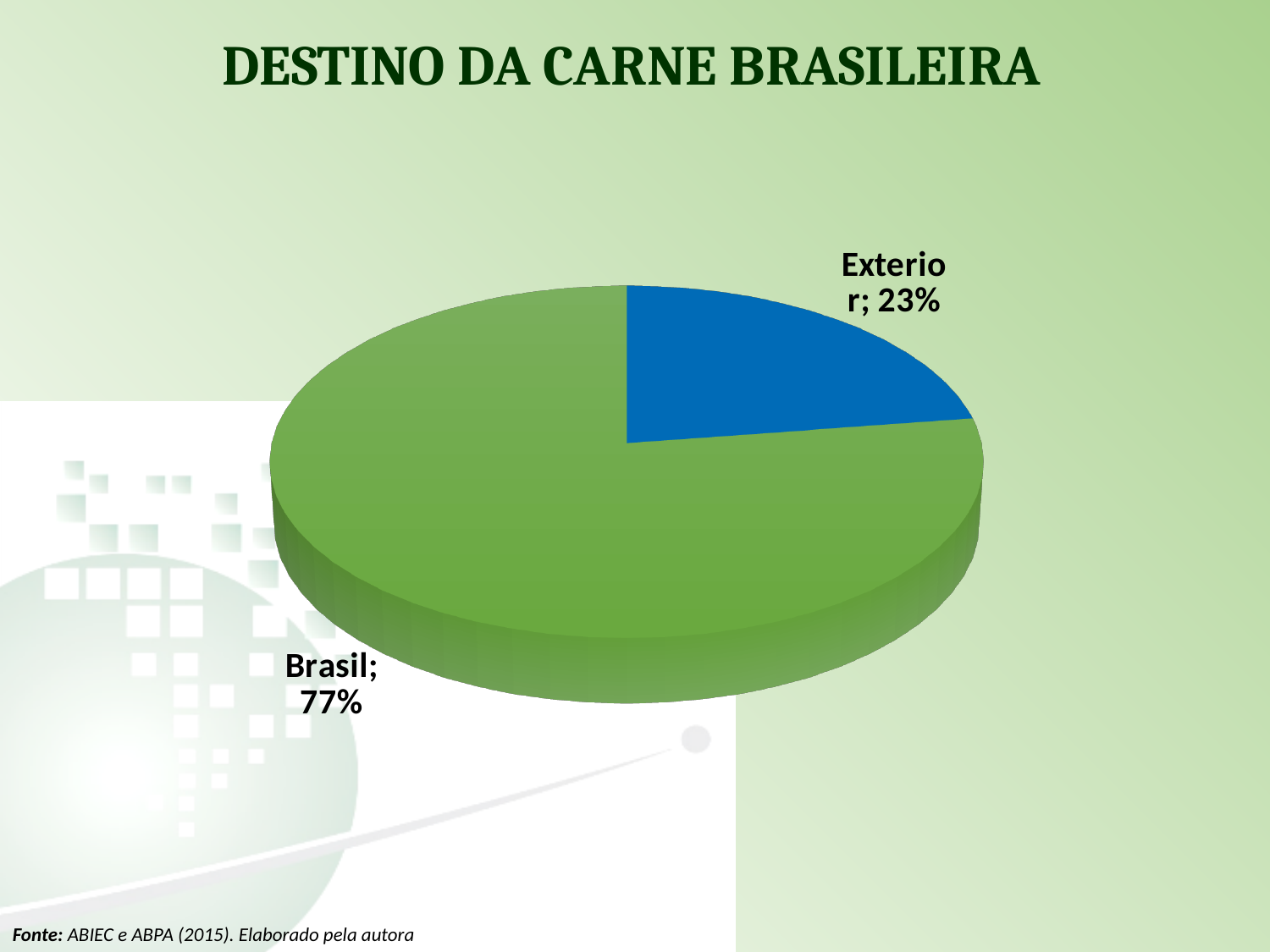
What is the total of the two slices shown? 100% What colour is the Exterior slice? Blue How many slices does the pie chart have? 2 What share of the pie does Brasil account for? 77% Which slice of the pie is the largest? Brasil Which slice of the pie is the smallest? Exterior What is the difference in percentage points between the Brasil and Exterior slices? 54 What share of the pie does Exterior account for? 23% Is the share for Brasil greater or less than 50%? greater What is the title of the chart? DESTINO DA CARNE BRASILEIRA Which is larger, the Brasil slice or the Exterior slice? Brasil What kind of chart is shown on the slide? Pie chart